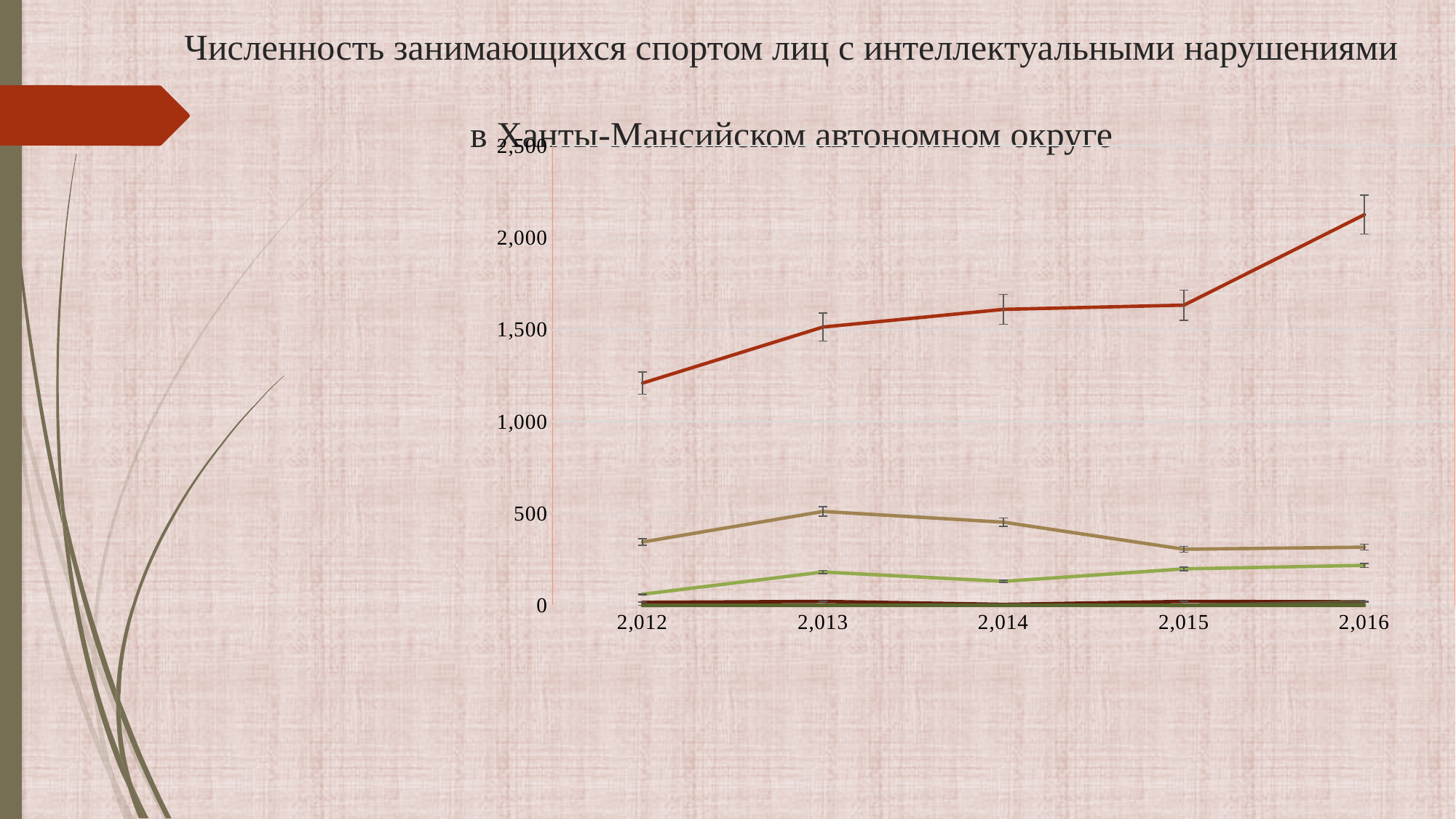
Is the value of the tan line in 2,015 greater or less than 500? less Is the value of the red line in 2,012 greater or less than 1,000? greater Is the value of the red line in 2,013 greater or less than 2,000? less Does the red line rise or fall from 2,012 to 2,016? rise In which year does the red line reach its highest value? 2,016 What is the highest value shown on the y axis of the chart? 2,500 In 2,014, which line is higher: the red line or the tan line? the red line How many years are shown along the x axis of the chart? 5 What kind of chart is shown on the slide? line chart